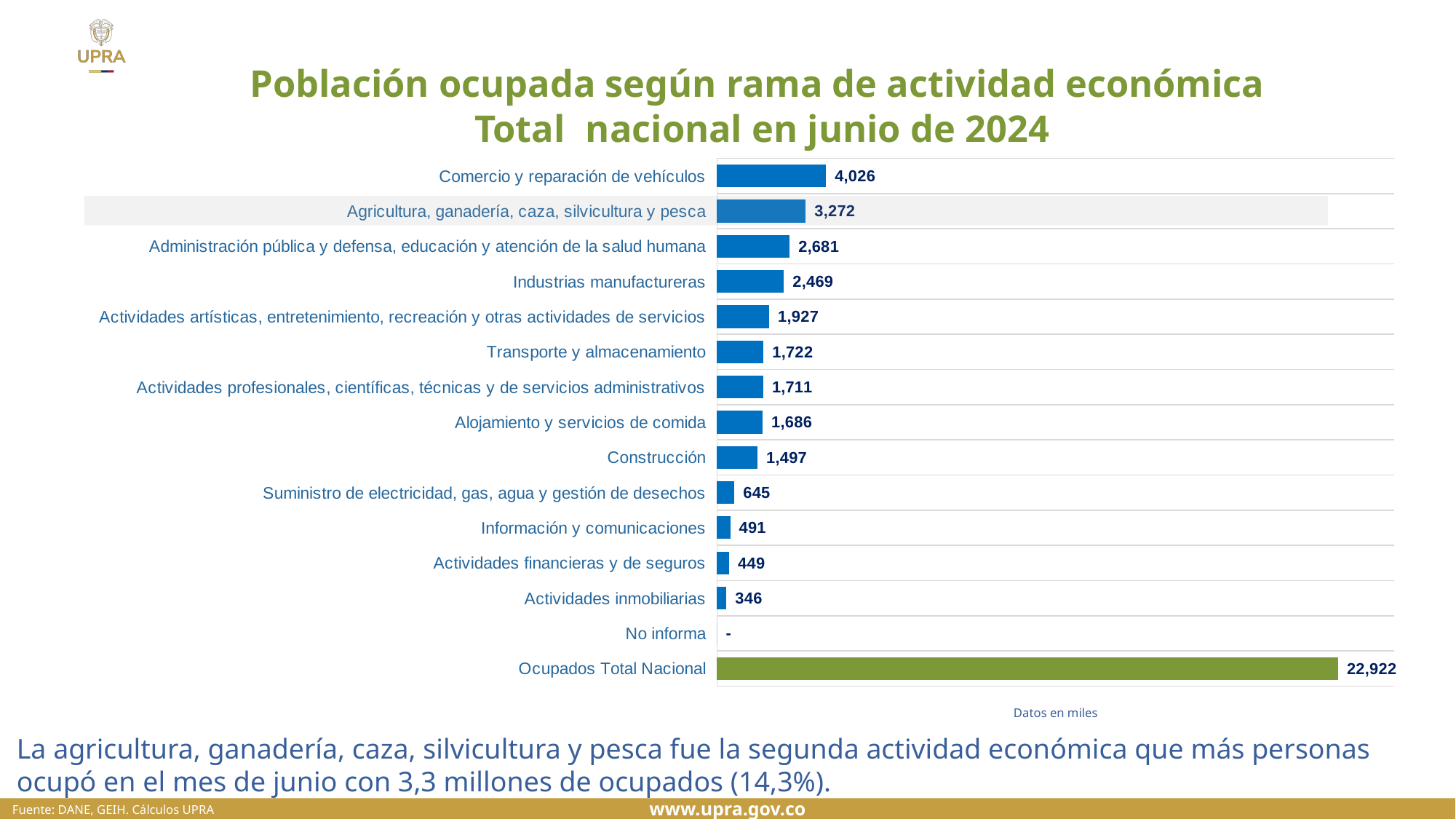
What is the value for Comercio y reparación de vehículos? 4,026 Excluding the Ocupados Total Nacional bar, which category has the highest value? Comercio y reparación de vehículos How many category labels are listed along the vertical axis of the chart? 15 Which is larger, the value for Construcción or the value for Suministro de electricidad, gas, agua y gestión de desechos? Construcción What is the value for Ocupados Total Nacional? 22,922 According to the note below the chart, in what units are the data expressed? Datos en miles Among the categories with a printed numeric value, which has the lowest value? Actividades inmobiliarias What type of chart is shown on the slide? bar chart What is the value for Industrias manufactureras? 2,469 What is the value for Agricultura, ganadería, caza, silvicultura y pesca? 3,272 What is the value for Actividades inmobiliarias? 346 What is the difference between the values for Comercio y reparación de vehículos and Agricultura, ganadería, caza, silvicultura y pesca? 754